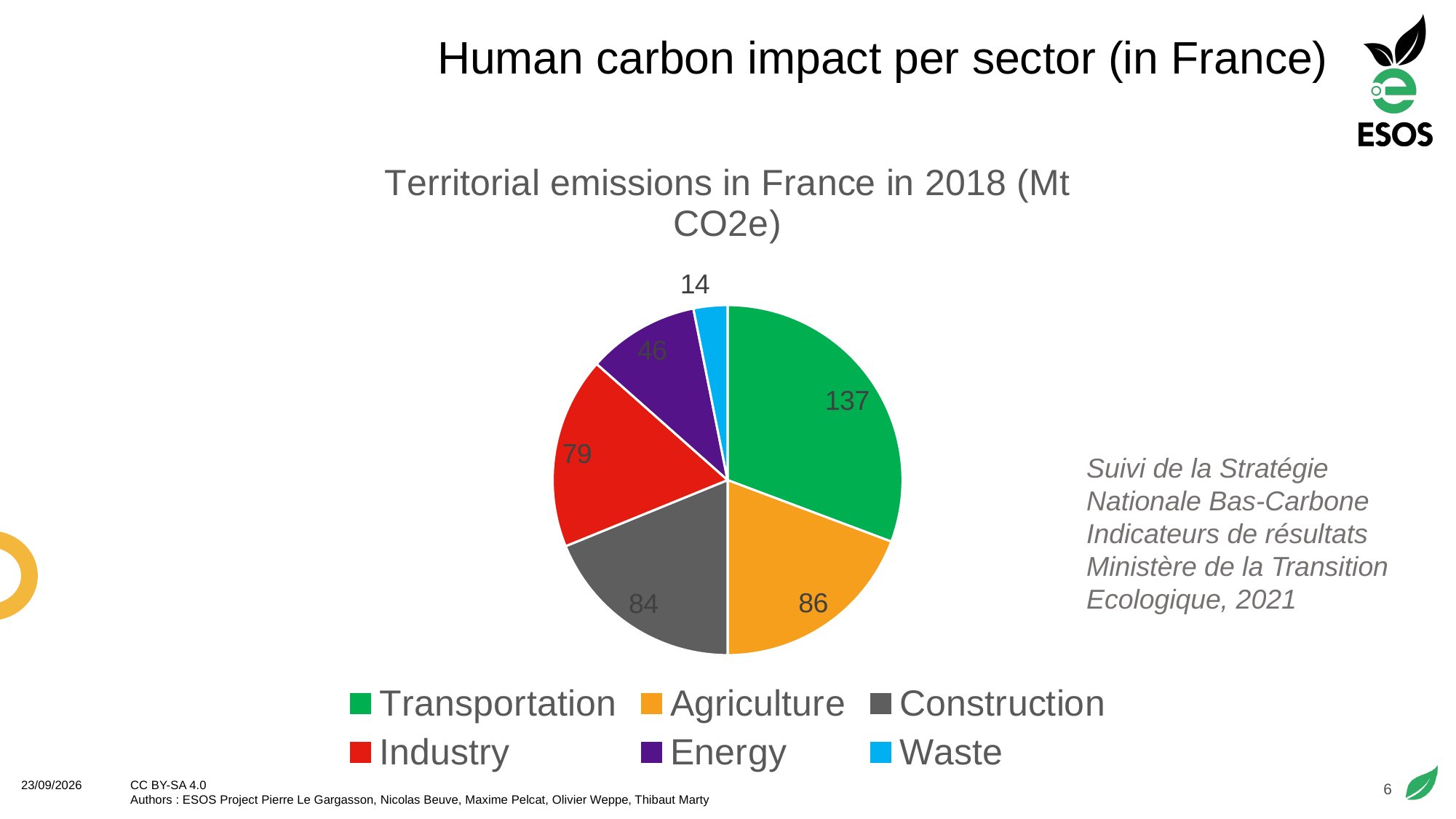
What type of chart is shown on the slide? Pie chart What is the title of the chart? Territorial emissions in France in 2018 (Mt CO2e) What is the value for Transportation in the pie chart? 137 Which sector has the smallest slice of the pie chart? Waste Which sector has the largest slice of the pie chart? Transportation What is the value for Industry in the pie chart? 79 What is the value for Energy in the pie chart? 46 What is the difference between the values for Transportation and Agriculture? 51 How many sectors are shown in the pie chart? 6 What is the total of all the values shown in the pie chart? 446 Which is larger, the value for Industry or the value for Energy? Industry What is the value for Waste in the pie chart? 14